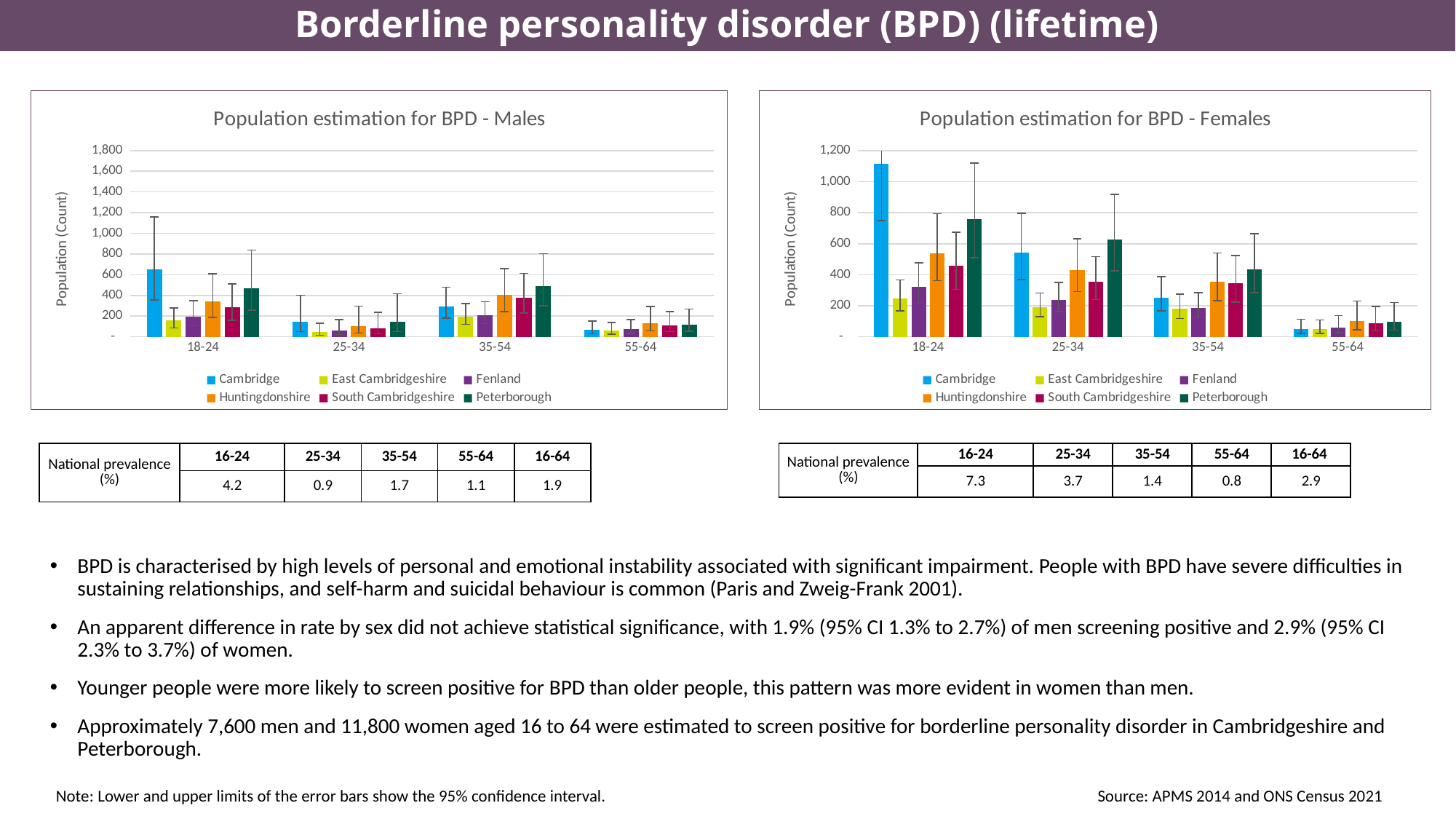
What kind of chart is 'Population estimation for BPD - Males'? bar chart In the 'Population estimation for BPD - Females' chart, do the Cambridge values rise or fall as the age groups go from 18-24 to 55-64? fall In the 'Population estimation for BPD - Females' chart, which is larger in the 18-24 age group: Huntingdonshire or East Cambridgeshire? Huntingdonshire How many series does the legend of the 'Population estimation for BPD - Females' chart list? 6 In the 'Population estimation for BPD - Males' chart, which is larger in the 18-24 age group: Cambridge or Peterborough? Cambridge In the 'Population estimation for BPD - Males' chart, which age group has the tallest bar for Cambridge? 18-24 What is the y-axis label of the 'Population estimation for BPD - Females' chart? Population (Count) In the 'Population estimation for BPD - Females' chart, is the value for Peterborough in the 18-24 age group greater or less than 600? greater In the 'Population estimation for BPD - Females' chart, is the value for Cambridge in the 18-24 age group greater or less than 1,000? greater In the 'Population estimation for BPD - Males' chart, is the value for Cambridge in the 18-24 age group greater or less than 400? greater How many age groups are shown on the x axis of the 'Population estimation for BPD - Males' chart? 4